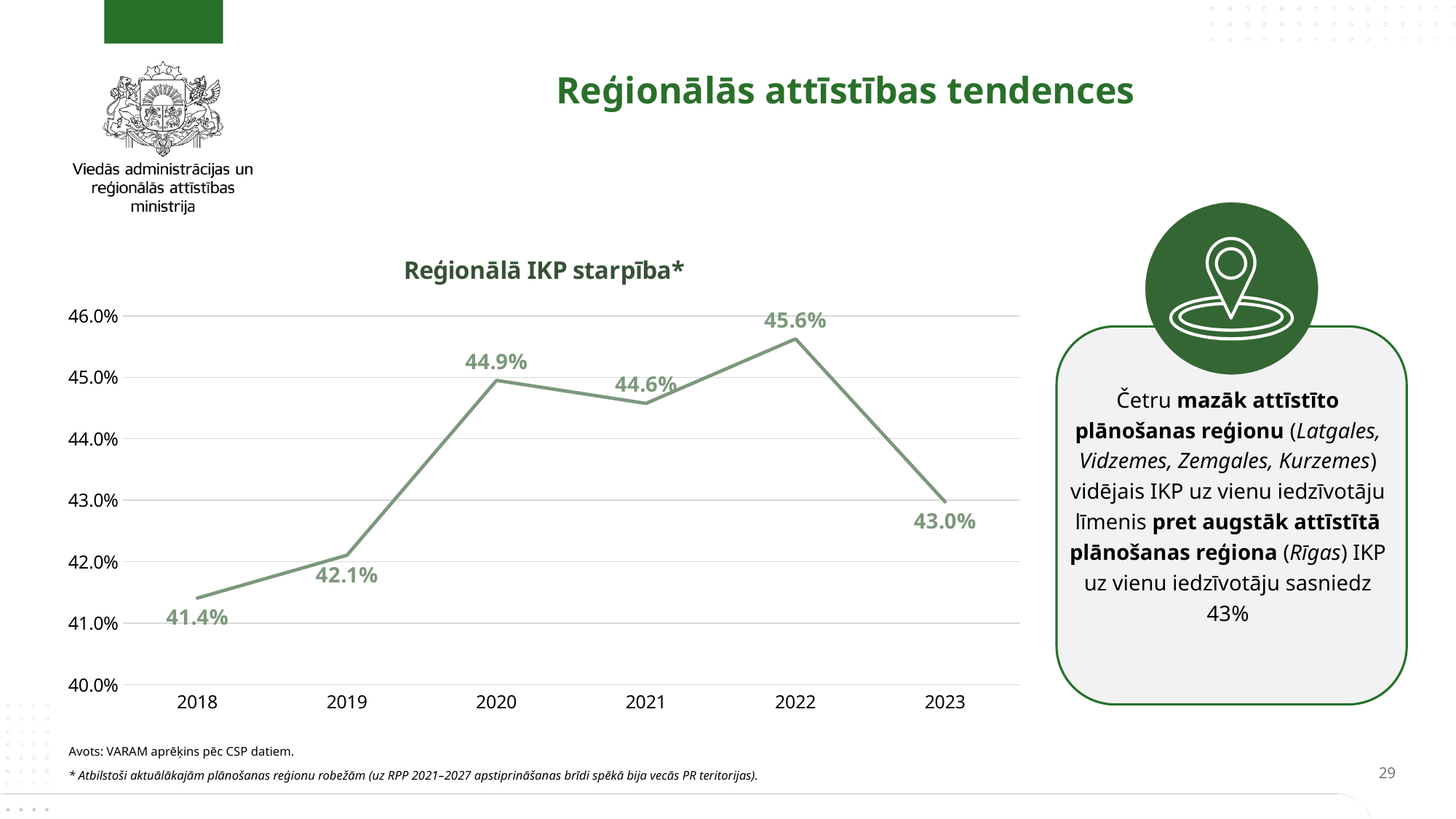
What is the difference between the 2020 and 2019 values in the Reģionālā IKP starpība* chart? 2.8% What kind of chart is the Reģionālā IKP starpība* chart? line chart What is the value for 2018 in the Reģionālā IKP starpība* chart? 41.4% Does the value in the Reģionālā IKP starpība* chart rise or fall from 2018 to 2020? rise What is the difference between the 2022 and 2023 values in the Reģionālā IKP starpība* chart? 2.6% What is the value for 2022 in the Reģionālā IKP starpība* chart? 45.6% Which year has the highest value in the Reģionālā IKP starpība* chart? 2022 Is the value for 2019 in the Reģionālā IKP starpība* chart greater or less than 43.0%? less Which is larger in the Reģionālā IKP starpība* chart, the value for 2020 or the value for 2021? 2020 How many years are plotted in the Reģionālā IKP starpība* chart? 6 Which year has the lowest value in the Reģionālā IKP starpība* chart? 2018 What is the value for 2023 in the Reģionālā IKP starpība* chart? 43.0%